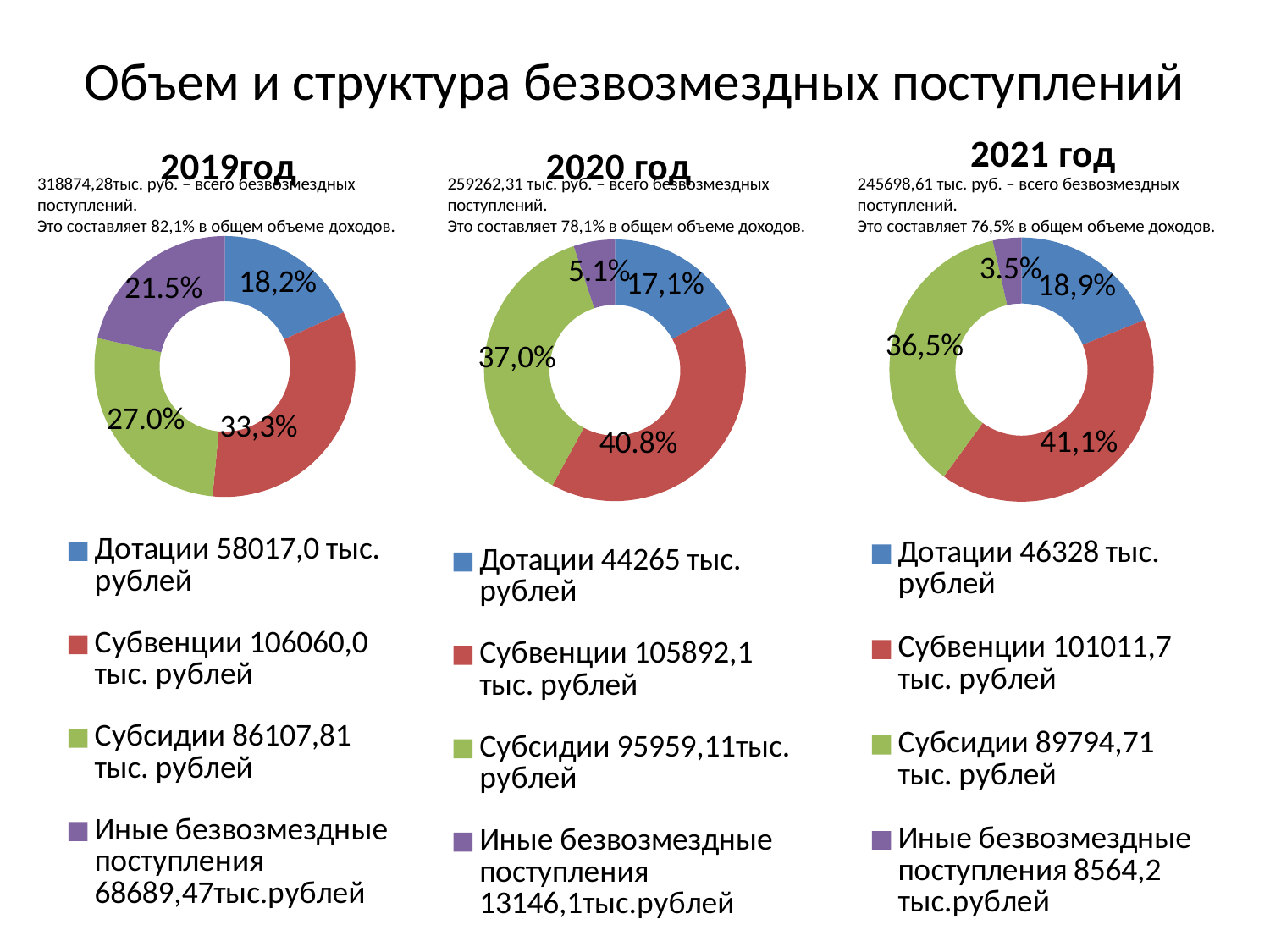
In the 2019 год chart, which category has the smallest share? Дотации In the 2021 год chart, what share is shown for Иные безвозмездные поступления? 3.5% In the 2019 год chart, what share is shown for Субвенции? 33,3% What kind of chart is used for the 2019 год data? Doughnut (pie) chart In the 2020 год chart, which category has the smallest share? Иные безвозмездные поступления In the 2021 год chart, which category has the largest share? Субвенции According to the legend of the 2021 год chart, what amount is given for Дотации? 46328 тыс. рублей How many categories does the legend of the 2020 год chart list? 4 In the 2020 год chart, what share is shown for Субсидии? 37,0% In the 2021 год chart, what is the difference between the shares for Субвенции and Дотации? 22,2% What is the title of the slide? Объем и структура безвозмездных поступлений In the 2019 год chart, which is larger: the share for Субсидии or the share for Иные безвозмездные поступления? Субсидии